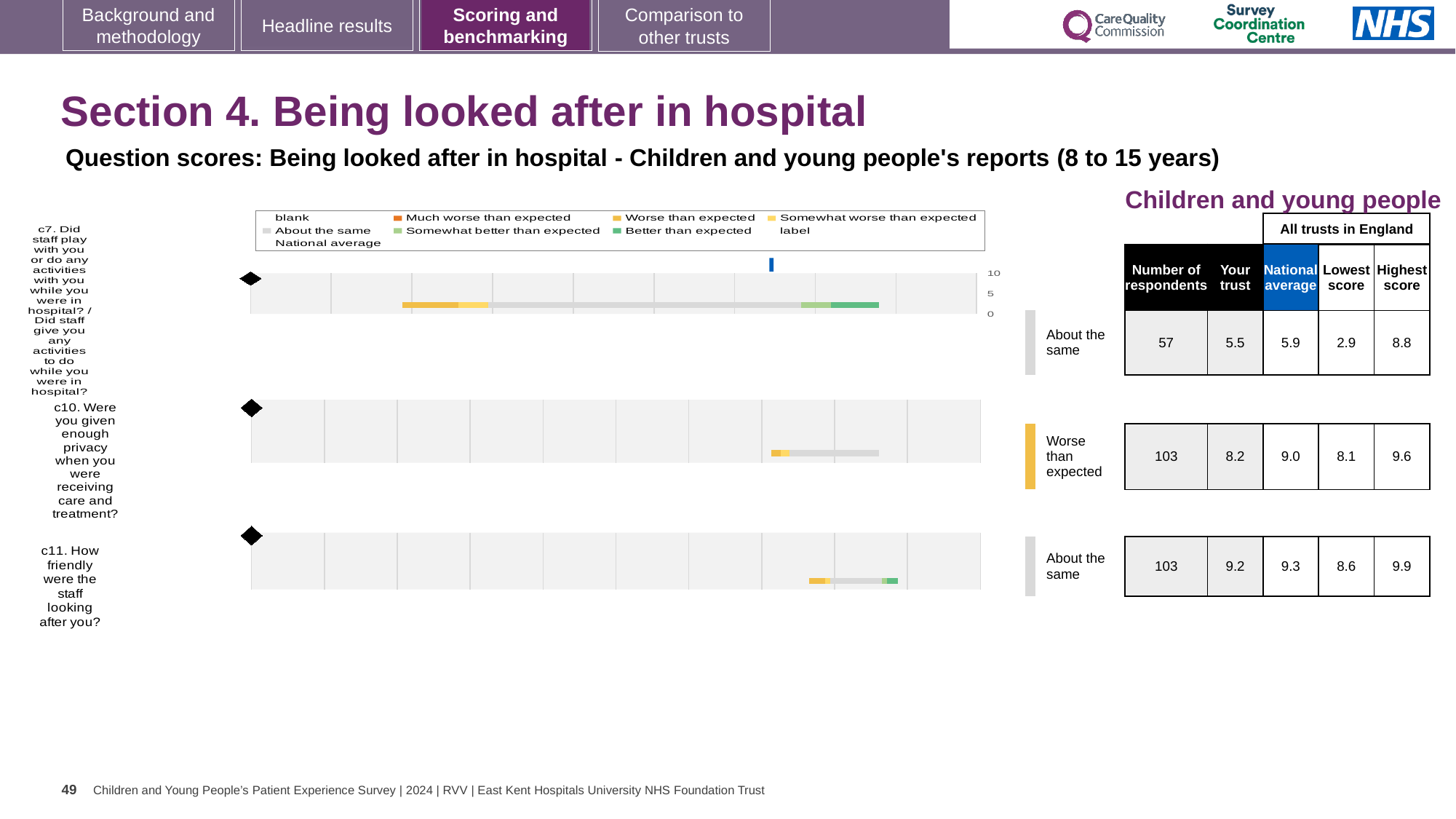
What is the highest score among all trusts in England for question c7? 8.8 How many respondents answered question c7 (Did staff play with you or do any activities with you while you were in hospital?)? 57 What benchmark category is shown for question c10 (privacy)? Worse than expected What kind of chart is used to show the question scores? Bar chart Which question has the lowest 'Your trust' score? c7. Did staff play with you or do any activities with you while you were in hospital? What is the national average score for question c11 (How friendly were the staff looking after you?)? 9.3 Which question has the highest 'Your trust' score? c11. How friendly were the staff looking after you? What is the lowest score among all trusts in England for question c11? 8.6 For question c10, what is the difference between the national average and the 'Your trust' score? 0.8 What is the 'Your trust' score for question c10 (Were you given enough privacy when you were receiving care and treatment?)? 8.2 For question c7, which is larger: the 'Your trust' score or the national average? National average How many questions are plotted on the slide? 3